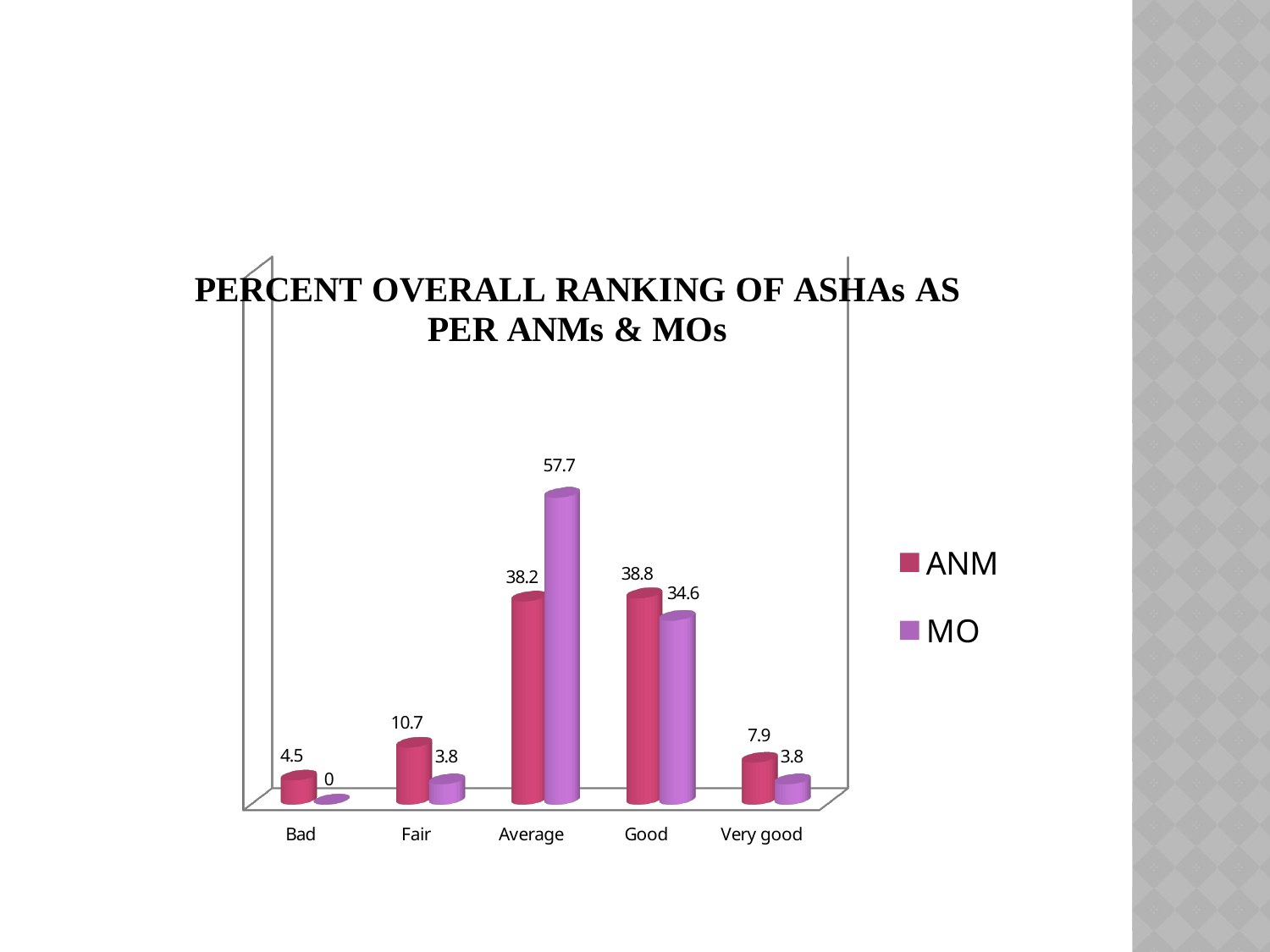
What is the ANM value for the Average category? 38.2 How many series does the legend list? 2 Which category has the highest MO value? Average What kind of chart is shown on the slide? Bar chart What is the MO value for the Average category? 57.7 What is the title of the chart? PERCENT OVERALL RANKING OF ASHAs AS PER ANMs & MOs What is the ANM value for the Fair category? 10.7 Which category has the lowest ANM value? Bad What is the difference between the MO and ANM values for the Average category? 19.5 For the Good category, which series has the larger value, ANM or MO? ANM How many categories are shown on the x axis? 5 What is the MO value for the Bad category? 0